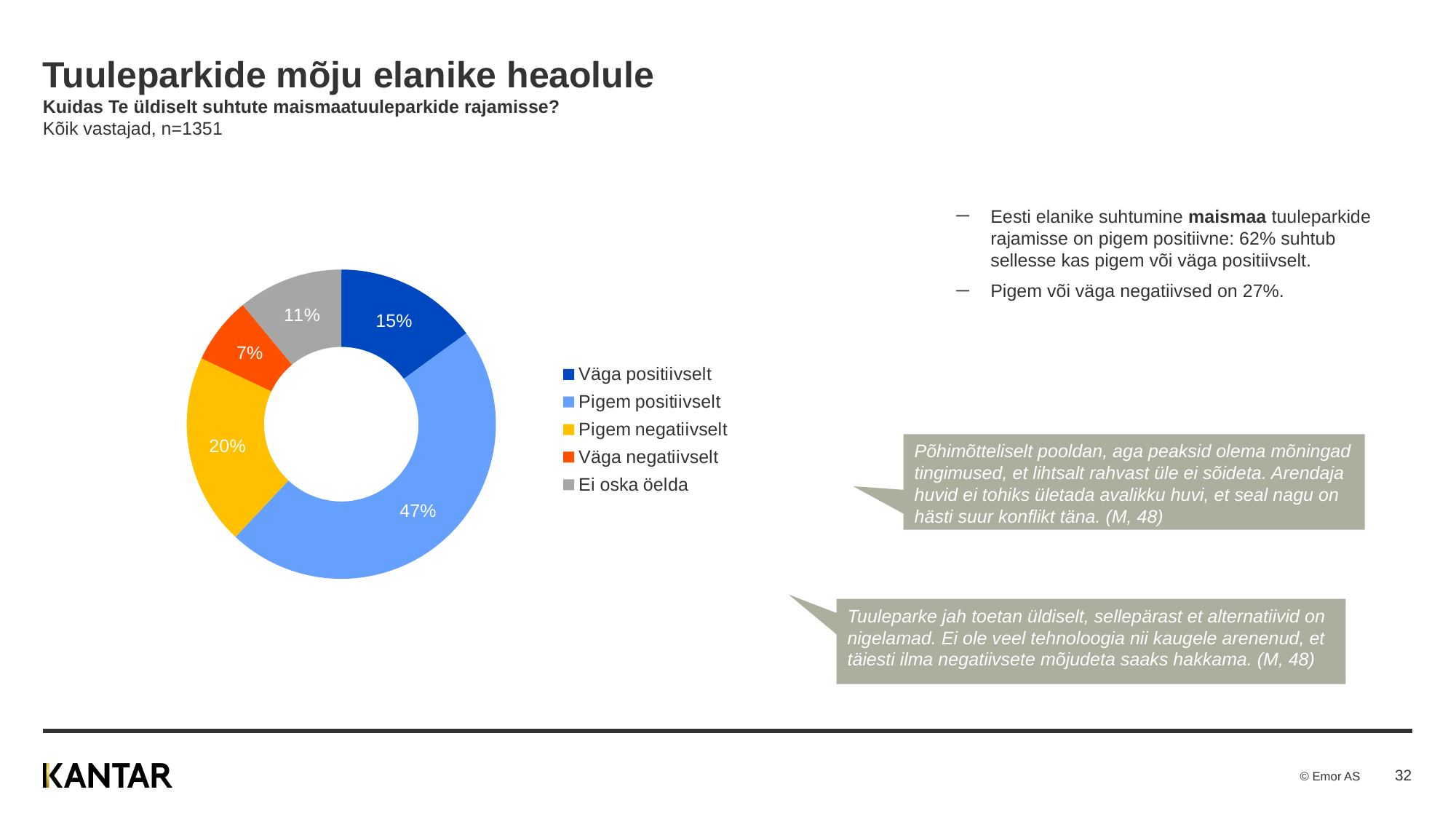
What is the difference in percentage points between "Pigem positiivselt" and "Pigem negatiivselt"? 27 Which is larger, the share for "Väga positiivselt" or for "Ei oska öelda"? Väga positiivselt Which response category has the smallest share? Väga negatiivselt What kind of chart is shown on the slide? Doughnut (pie) chart What share of respondents answered "Ei oska öelda"? 11% What share of respondents answered "Väga negatiivselt"? 7% What share of respondents answered "Pigem negatiivselt"? 20% What share of respondents answered "Pigem positiivselt"? 47% What share of respondents answered "Väga positiivselt"? 15% How many response categories does the chart show? 5 Which response category has the largest share? Pigem positiivselt What colour represents "Pigem negatiivselt" in the chart? Yellow